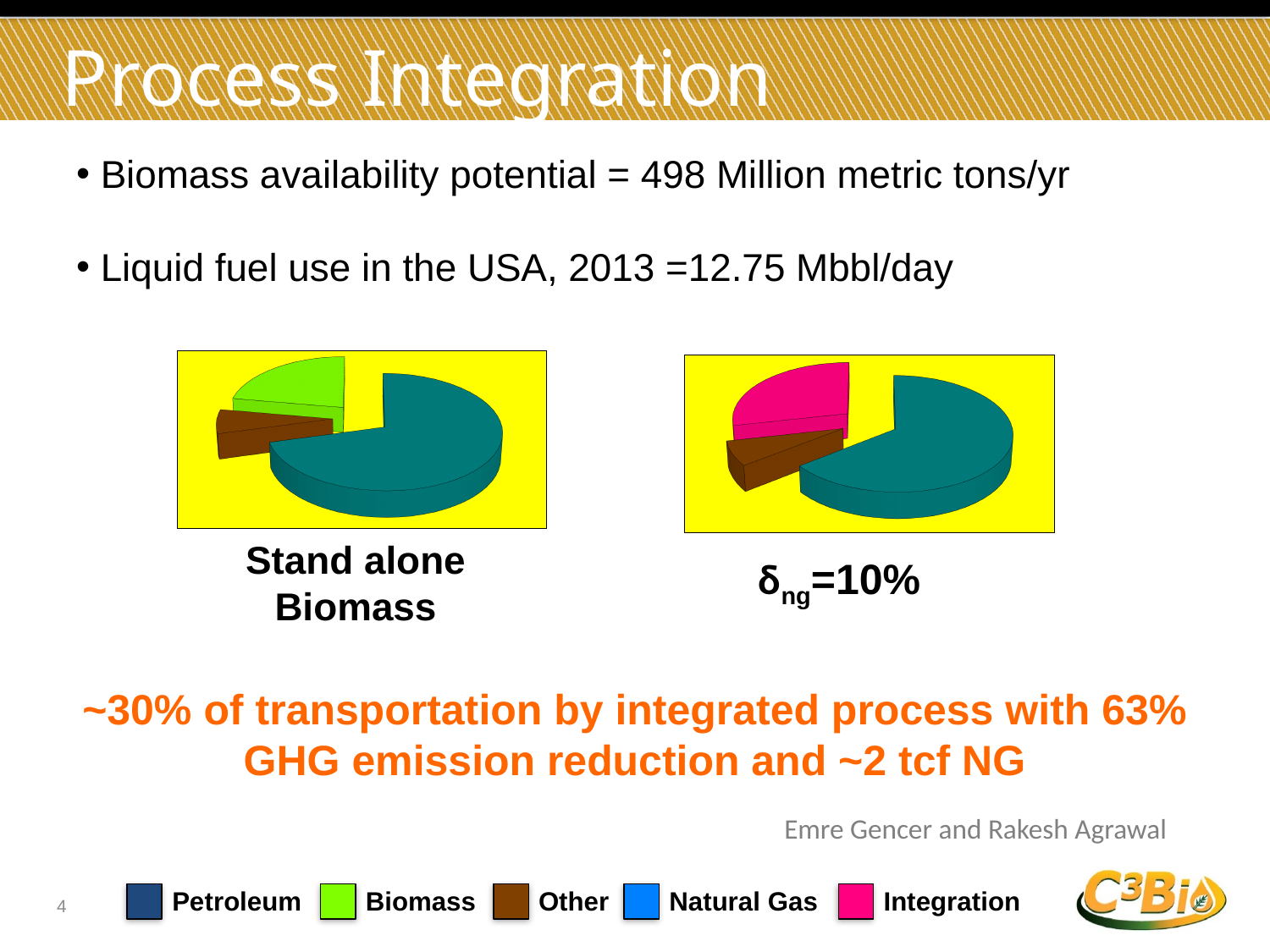
What kind of chart is the 'Stand alone Biomass' chart? pie chart How many entries does the legend at the bottom of the slide list? 5 What kind of chart is the chart labelled 'δng=10%'? pie chart In the 'Stand alone Biomass' pie chart, which colour slice is the smallest? brown In the 'δng=10%' pie chart, which colour slice is the largest? teal In the 'Stand alone Biomass' pie chart, is the green slice larger or smaller than the teal slice? smaller What is the caption under the left pie chart? Stand alone Biomass How many slices does the 'Stand alone Biomass' pie chart have? 3 In the 'Stand alone Biomass' pie chart, which colour slice is the largest? teal Which legend entry is shown in pink? Integration How many slices does the 'δng=10%' pie chart have? 3 In the 'δng=10%' pie chart, which colour slice is the smallest? brown